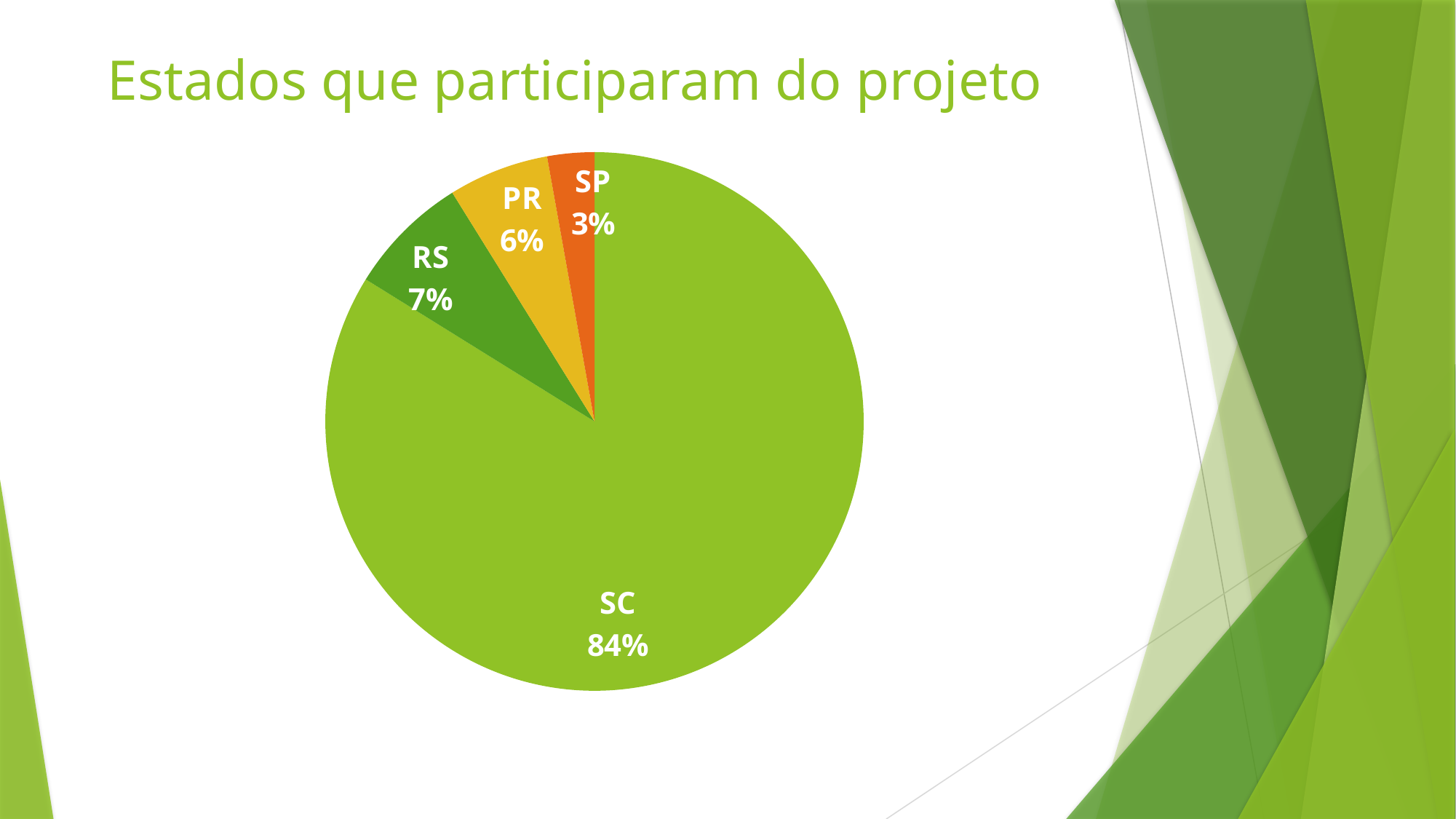
How many states are shown in the pie chart? 4 Which state has the smallest slice of the pie? SP What is the share for RS? 7% What is the share for SP? 3% What is the title of the slide containing the chart? Estados que participaram do projeto Which state has the largest slice of the pie? SC Which is larger, the share for RS or the share for PR? RS What is the share for PR? 6% What type of chart is shown on the slide? pie chart What is the difference in percentage points between SC and RS? 77 What is the share for SC? 84% What is the combined share of RS, PR and SP? 16%